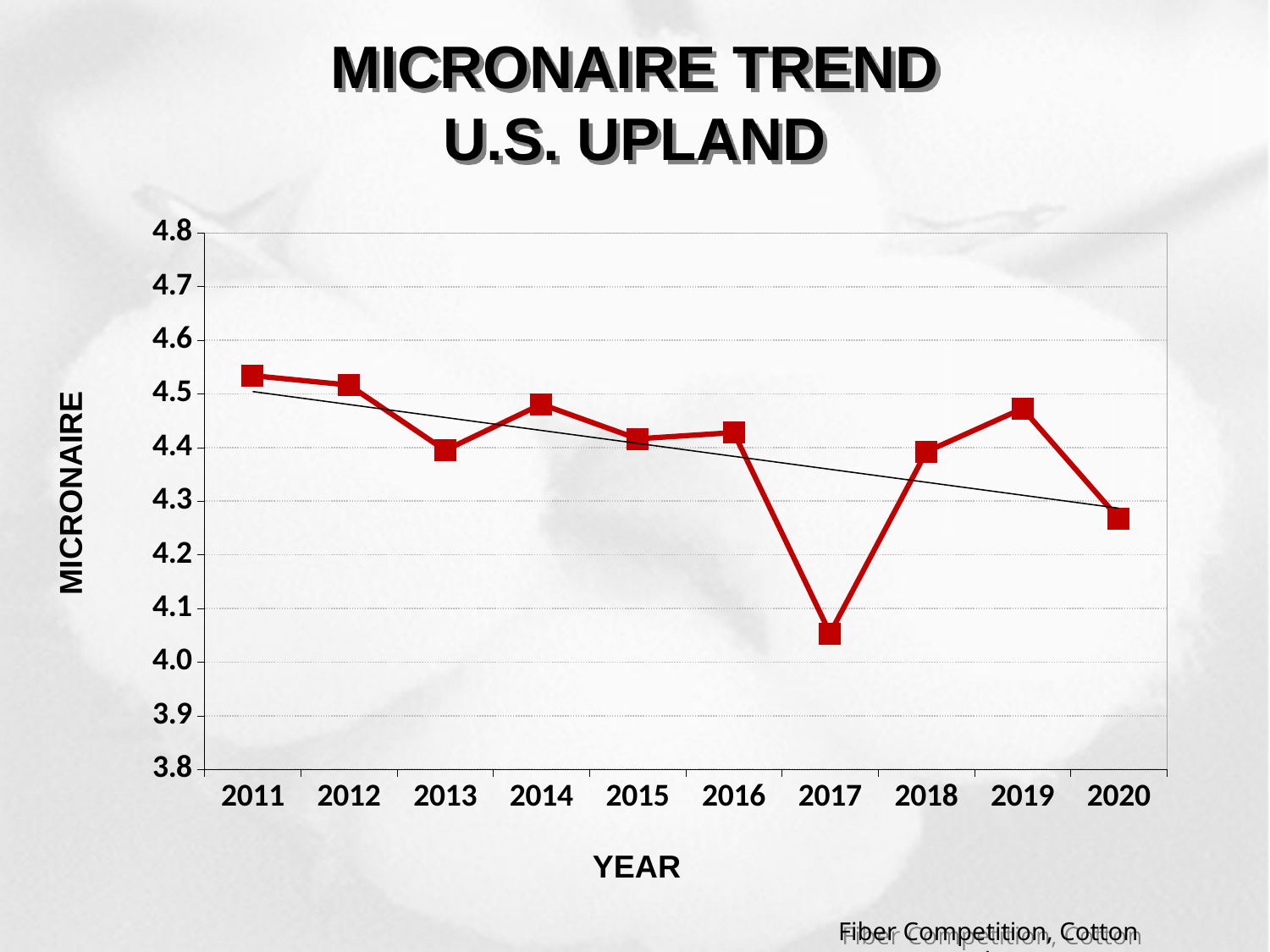
What is the label on the y axis of the chart? MICRONAIRE Is the micronaire value for 2020 greater or less than 4.3? less Which year has the larger micronaire value, 2017 or 2020? 2020 How many years are plotted on the x axis? 10 Overall, do micronaire values rise or fall from 2011 to 2020? fall Which year has the larger micronaire value, 2011 or 2013? 2011 Is the micronaire value for 2017 greater or less than 4.1? less Is the micronaire value for 2013 greater or less than 4.5? less What kind of chart is shown on the slide? line chart Which year has the lowest micronaire value? 2017